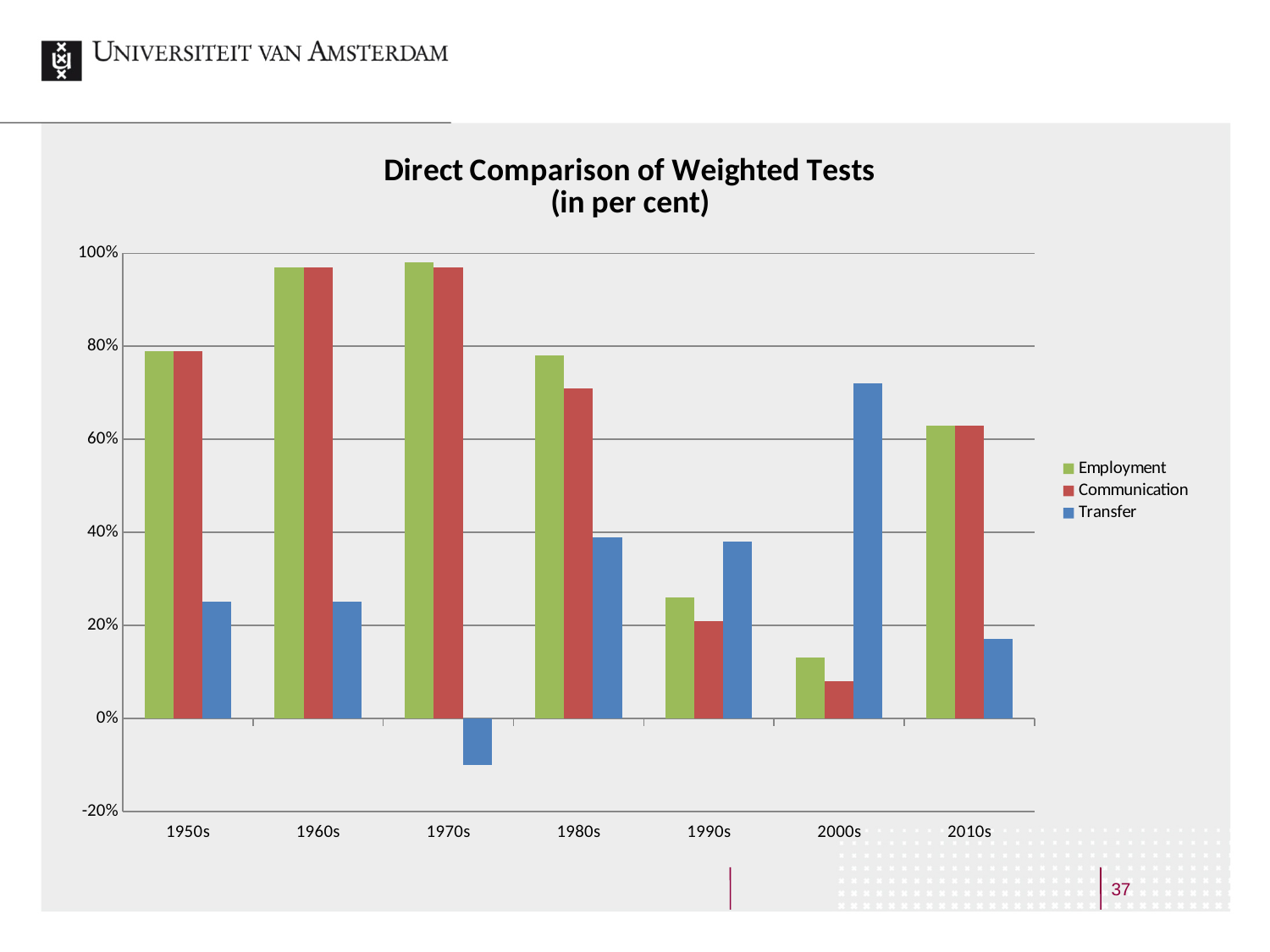
In which decade is the Transfer value highest? 2000s Is the value for Employment in the 1960s greater or less than 80%? greater What is the title of the chart? Direct Comparison of Weighted Tests (in per cent) In which decade is the Employment value lowest? 2000s Which colour represents the Transfer series in the legend? blue How many decades are shown on the x axis? 7 How many series does the legend list? 3 Is the value for Communication in the 2000s greater or less than 20%? less In the 1990s, which is larger: Transfer or Employment? Transfer Is the value for Transfer in the 1970s greater or less than 0%? less Does the Employment value rise or fall from the 1970s to the 2000s? fall What kind of chart is shown on the slide? bar chart